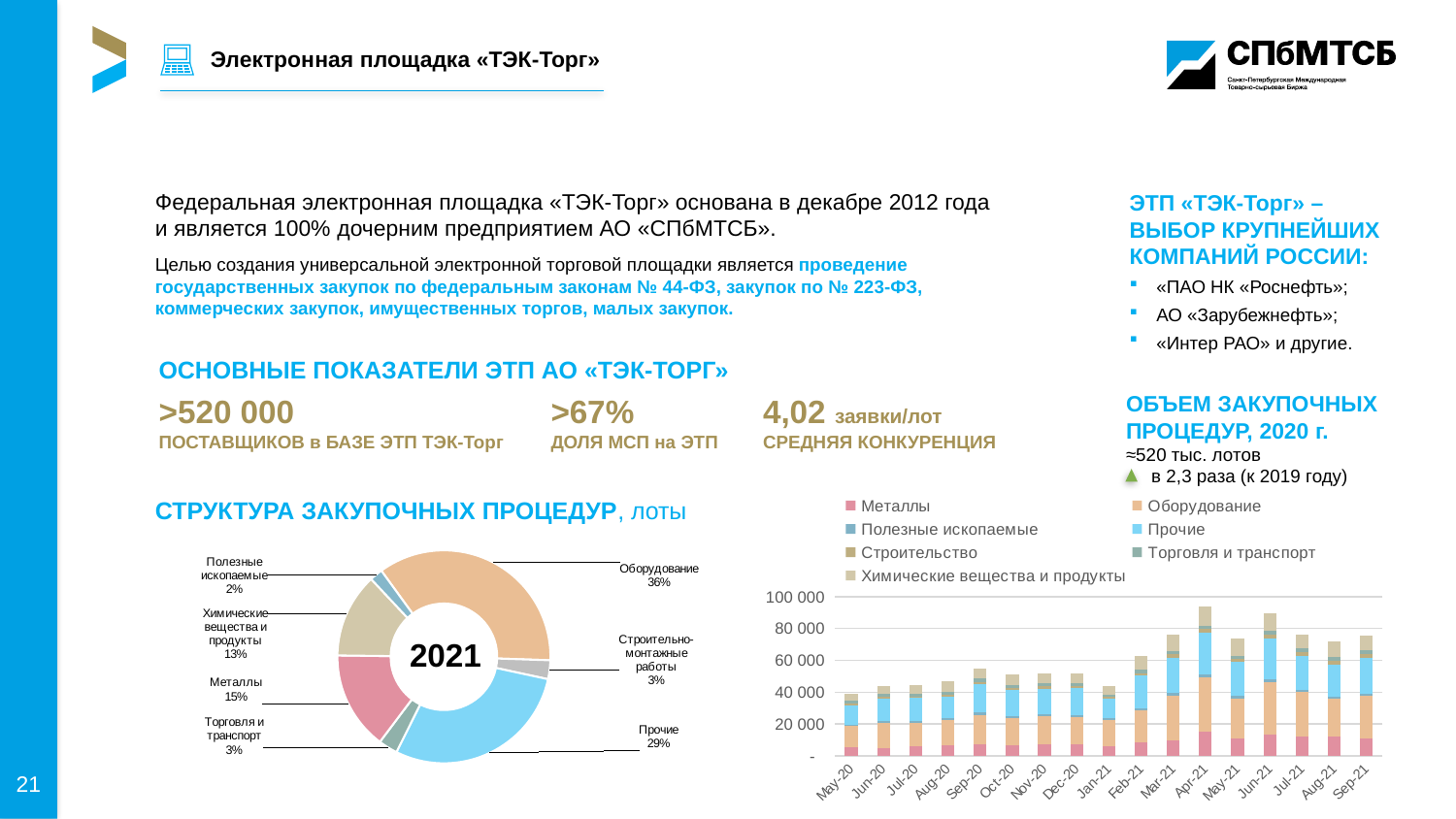
In the donut chart 'СТРУКТУРА ЗАКУПОЧНЫХ ПРОЦЕДУР, лоты', what share does 'Химические вещества и продукты' have? 13% What type of chart is the monthly chart on the right of the slide (May-20 to Sep-21)? Stacked bar chart In the donut chart 'СТРУКТУРА ЗАКУПОЧНЫХ ПРОЦЕДУР, лоты', what share does 'Прочие' have? 29% In the donut chart 'СТРУКТУРА ЗАКУПОЧНЫХ ПРОЦЕДУР, лоты', which category has the smallest share? Полезные ископаемые In the monthly stacked bar chart on the right (May-20 to Sep-21), how many series does the legend list? 7 What year is shown in the centre of the donut chart 'СТРУКТУРА ЗАКУПОЧНЫХ ПРОЦЕДУР, лоты'? 2021 In the donut chart 'СТРУКТУРА ЗАКУПОЧНЫХ ПРОЦЕДУР, лоты', what is the difference in percentage points between 'Оборудование' and 'Прочие'? 7 In the monthly stacked bar chart on the right (May-20 to Sep-21), is the total for Apr-21 greater or less than 80 000? greater In the donut chart 'СТРУКТУРА ЗАКУПОЧНЫХ ПРОЦЕДУР, лоты', what share does 'Оборудование' have? 36% In the donut chart 'СТРУКТУРА ЗАКУПОЧНЫХ ПРОЦЕДУР, лоты', which is larger: 'Металлы' or 'Химические вещества и продукты'? Металлы In the donut chart 'СТРУКТУРА ЗАКУПОЧНЫХ ПРОЦЕДУР, лоты', how many categories are shown? 7 In the donut chart 'СТРУКТУРА ЗАКУПОЧНЫХ ПРОЦЕДУР, лоты', which category has the largest share? Оборудование